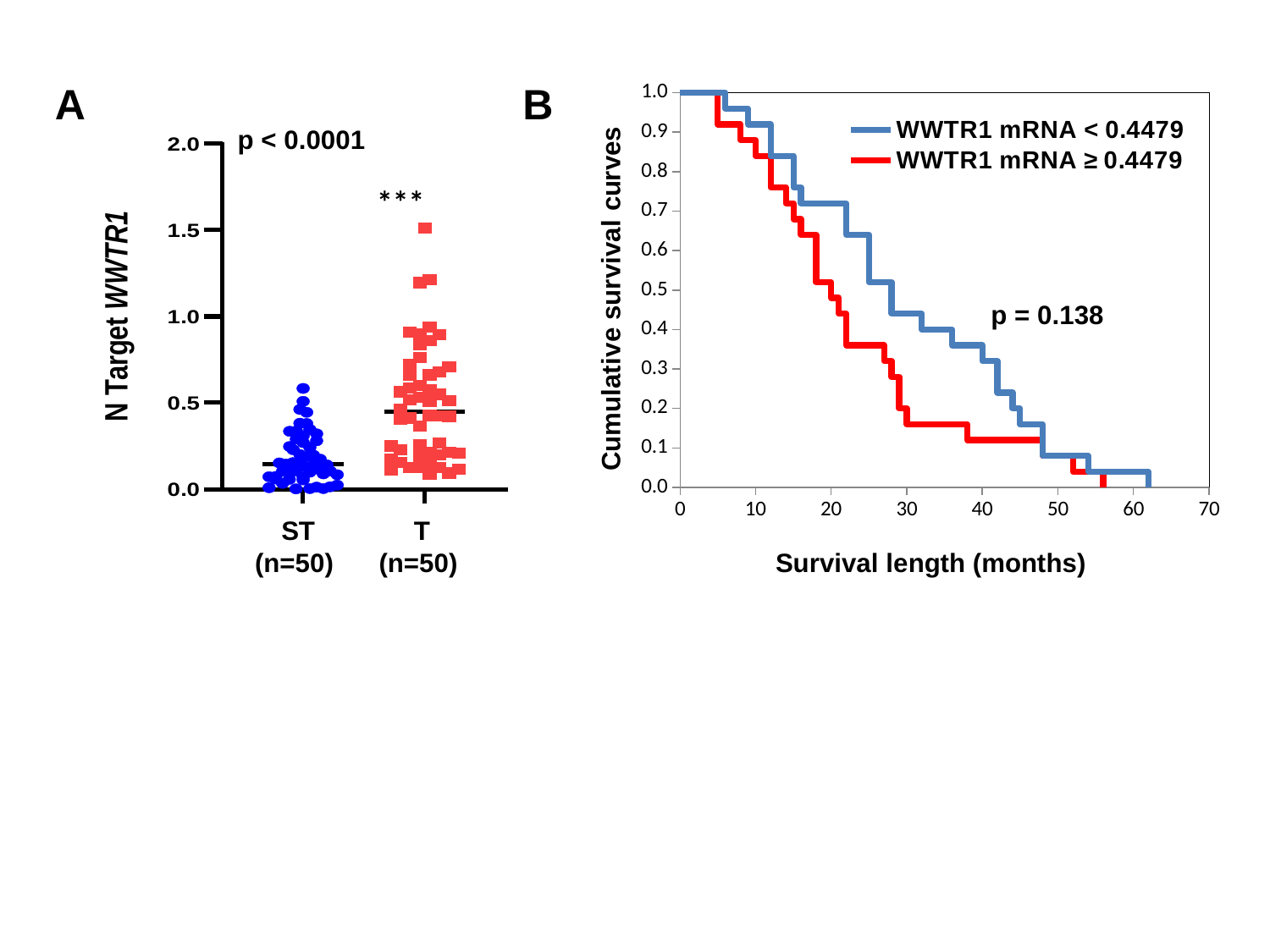
In chart A, is the highest point in the T group greater or less than 1.0? greater What kind of chart is chart B? Line chart (survival curves) In chart A, what is the sample size shown for the T group? n=50 In chart A, what p-value is printed above the plot? p < 0.0001 In chart B, what is the label of the x axis? Survival length (months) In chart B, what p-value is printed on the plot? p = 0.138 In chart B, how many series does the legend list? 2 In chart B, is the value of the WWTR1 mRNA < 0.4479 curve at 40 months greater or less than 0.5? less In chart B, which curve is higher at 30 months, WWTR1 mRNA < 0.4479 or WWTR1 mRNA ≥ 0.4479? WWTR1 mRNA < 0.4479 In chart A, how many groups are plotted on the x axis? 2 In chart A, which group has the higher median line, ST or T? T In chart A, is the highest point in the ST group greater or less than 1.0? less